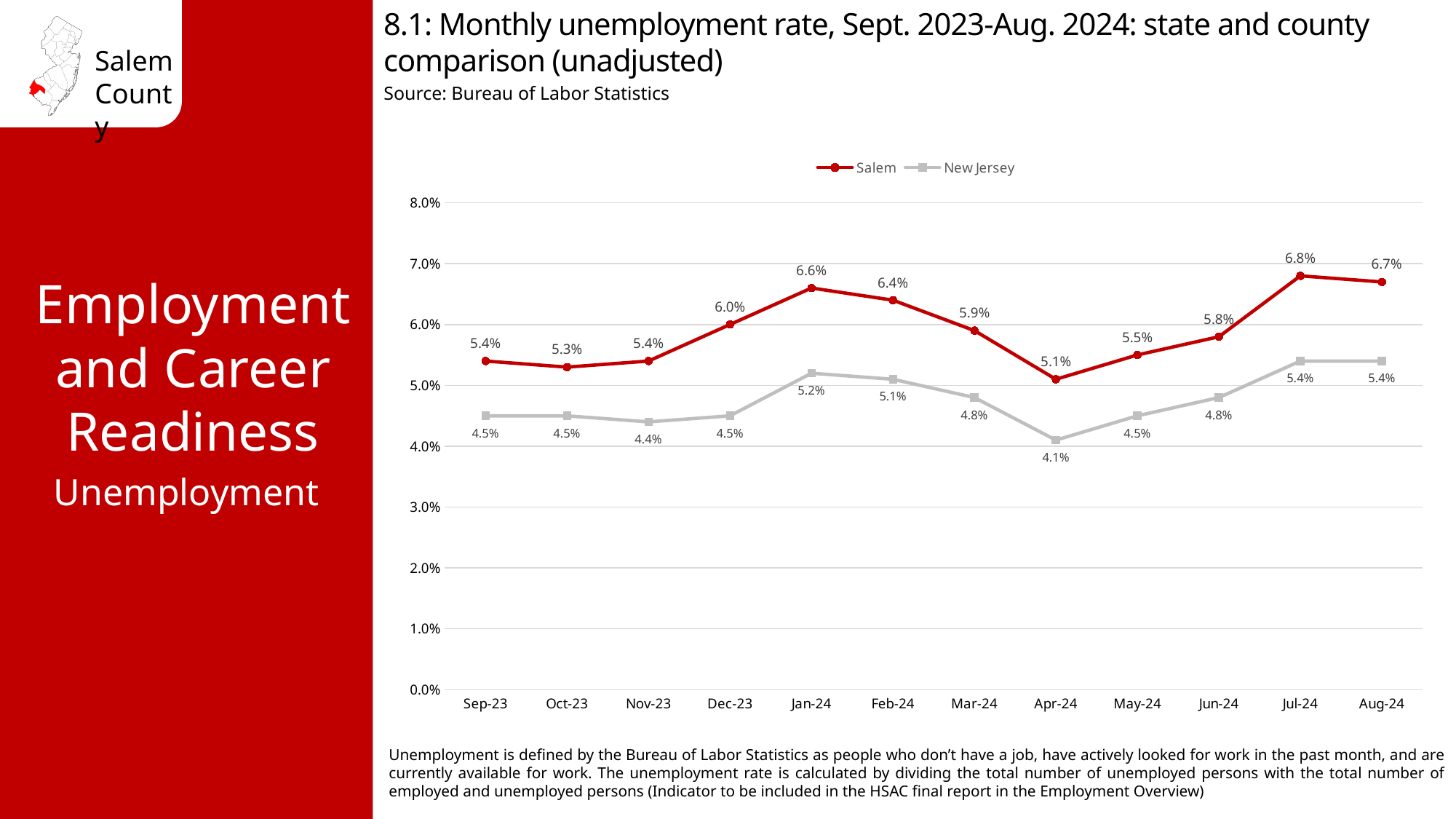
Did the Salem unemployment rate rise or fall from Apr-24 to Jul-24? Rise What is the difference between the Salem and New Jersey unemployment rates in Aug-24? 1.3% In which month did Salem have its highest unemployment rate? Jul-24 Is the Salem unemployment rate in Jul-24 greater or less than 6.0%? greater How many series does the legend list? 2 How many months are plotted on the x axis? 12 What was the New Jersey unemployment rate in Apr-24? 4.1% In which month did New Jersey have its lowest unemployment rate? Apr-24 What was the Salem unemployment rate in Jan-24? 6.6% Which series had the higher unemployment rate in Mar-24, Salem or New Jersey? Salem What kind of chart is shown on the slide? Line chart What is the source cited for the chart? Bureau of Labor Statistics